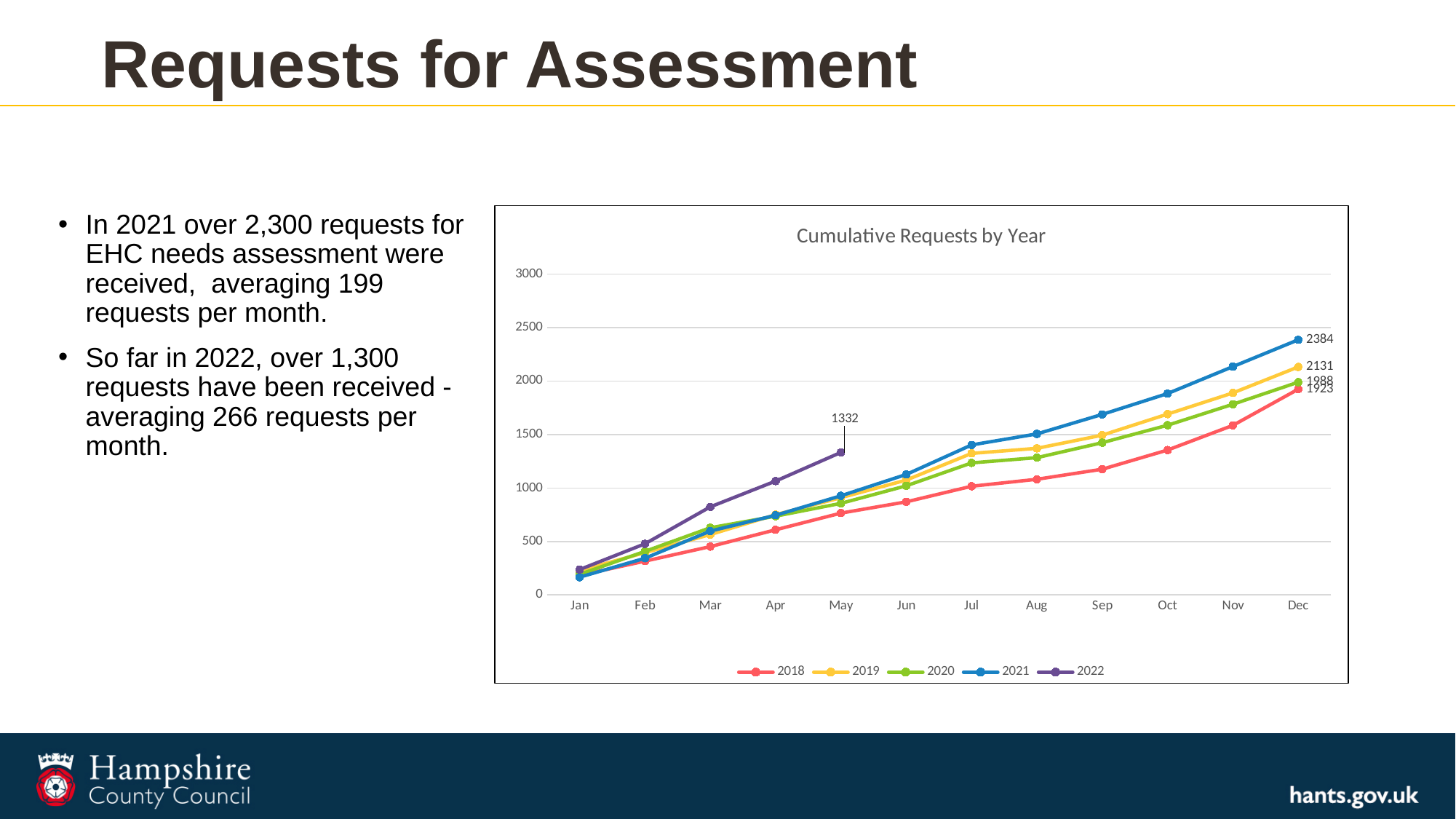
Which year has the highest cumulative requests in Dec? 2021 Which year has the larger Dec value, 2019 or 2020? 2019 How many series does the legend of the chart list? 5 What is the difference between the Dec values for 2021 and 2019? 253 What kind of chart is shown on the slide? Line chart What is the difference between the Dec values for 2021 and 2018? 461 What is the cumulative number of requests for 2018 in Dec? 1923 What is the cumulative number of requests for 2022 in May? 1332 Is the value for 2018 in Oct greater or less than 1500? less What is the cumulative number of requests for 2019 in Dec? 2131 How many months are shown along the x axis of the chart? 12 What is the cumulative number of requests for 2021 in Dec? 2384